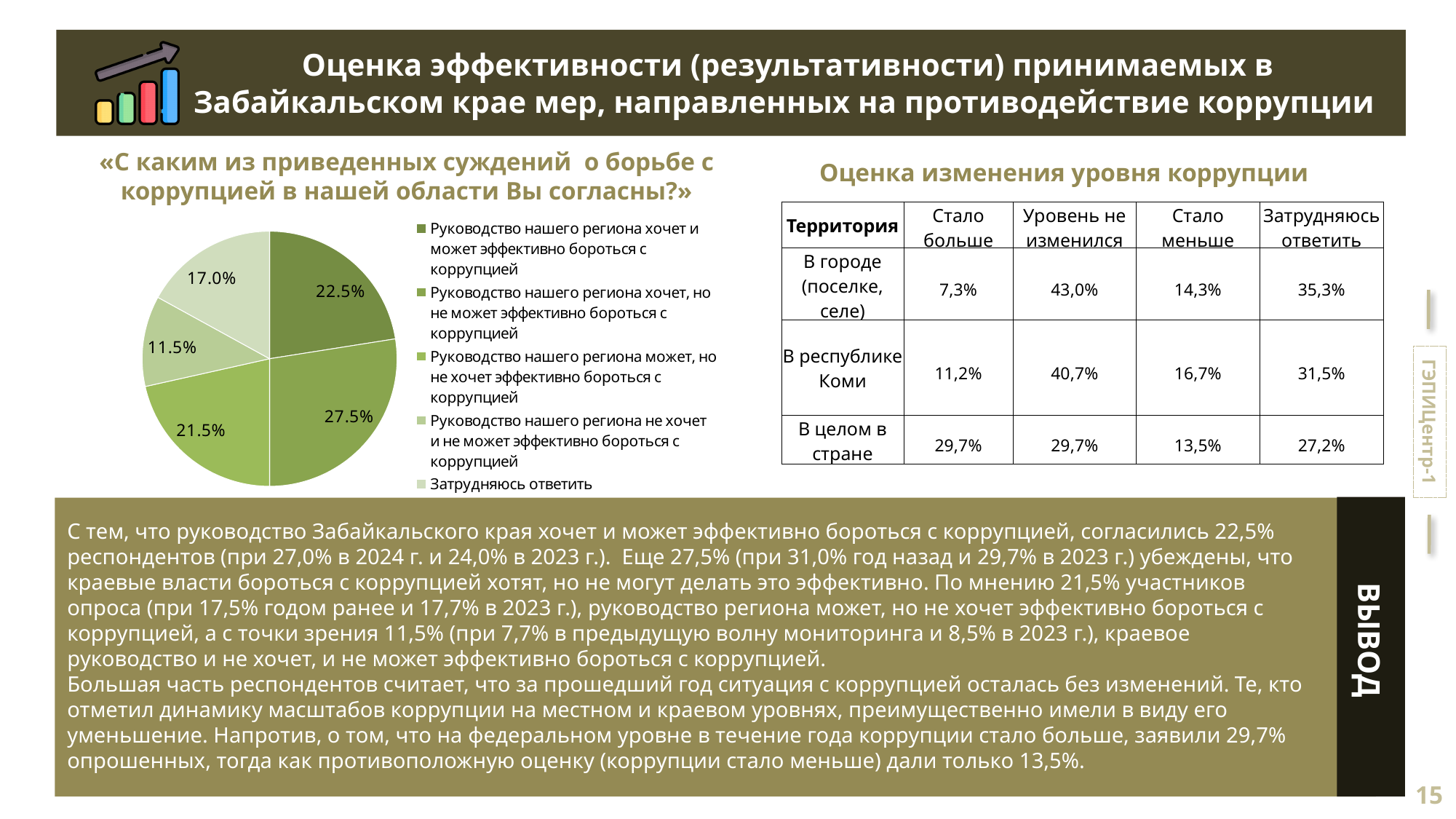
In the pie chart, which is larger: the 'Затрудняюсь ответить' slice or the 'не хочет и не может' slice? Затрудняюсь ответить In the pie chart, what is the value for 'Руководство нашего региона не хочет и не может эффективно бороться с коррупцией'? 11.5% In the pie chart, what is the value for 'Руководство нашего региона может, но не хочет эффективно бороться с коррупцией'? 21.5% Which slice of the pie chart is the smallest? Руководство нашего региона не хочет и не может эффективно бороться с коррупцией Which slice of the pie chart is the largest? Руководство нашего региона хочет, но не может эффективно бороться с коррупцией How many slices does the pie chart have? 5 In the pie chart, what share of respondents answered 'Затрудняюсь ответить'? 17.0% In the pie chart, what is the value for 'Руководство нашего региона хочет, но не может эффективно бороться с коррупцией'? 27.5% What kind of chart is shown on the left of the slide? pie chart How many entries does the legend of the pie chart list? 5 In the pie chart, what share of respondents agreed that the regional leadership wants and can effectively fight corruption (Руководство нашего региона хочет и может эффективно бороться с коррупцией)? 22.5% In the pie chart, what is the difference between the 'хочет, но не может' slice and the 'хочет и может' slice? 5.0%